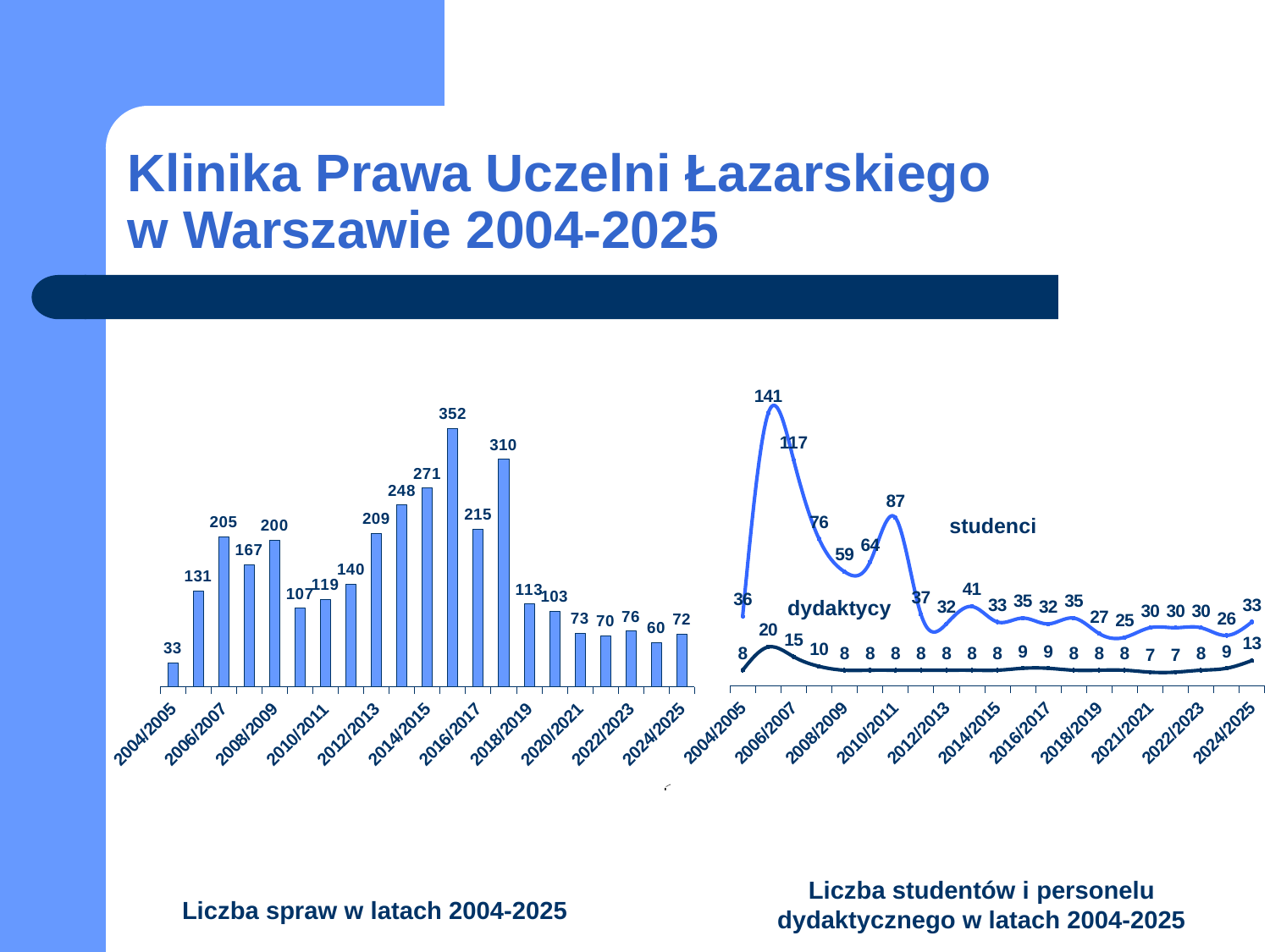
In the right chart 'Liczba studentów i personelu dydaktycznego w latach 2004-2025', what is the highest value of the 'studenci' series? 141 In the left chart 'Liczba spraw w latach 2004-2025', what is the value for 2004/2005? 33 In the left chart 'Liczba spraw w latach 2004-2025', what is the value for 2014/2015? 271 In the right chart 'Liczba studentów i personelu dydaktycznego w latach 2004-2025', what is the 'dydaktycy' value for 2024/2025? 13 In the left chart 'Liczba spraw w latach 2004-2025', which is larger: the value for 2006/2007 or for 2008/2009? 2006/2007 What kind of chart is the right chart, 'Liczba studentów i personelu dydaktycznego w latach 2004-2025'? line chart In the right chart 'Liczba studentów i personelu dydaktycznego w latach 2004-2025', what is the 'studenci' value for 2010/2011? 87 How many series are shown in the right chart 'Liczba studentów i personelu dydaktycznego w latach 2004-2025'? 2 In the left chart 'Liczba spraw w latach 2004-2025', what is the highest value shown? 352 In the left chart 'Liczba spraw w latach 2004-2025', what is the difference between the values for 2016/2017 and 2018/2019? 102 What kind of chart is the left chart, 'Liczba spraw w latach 2004-2025'? bar chart How many bars are plotted in the left chart 'Liczba spraw w latach 2004-2025'? 21